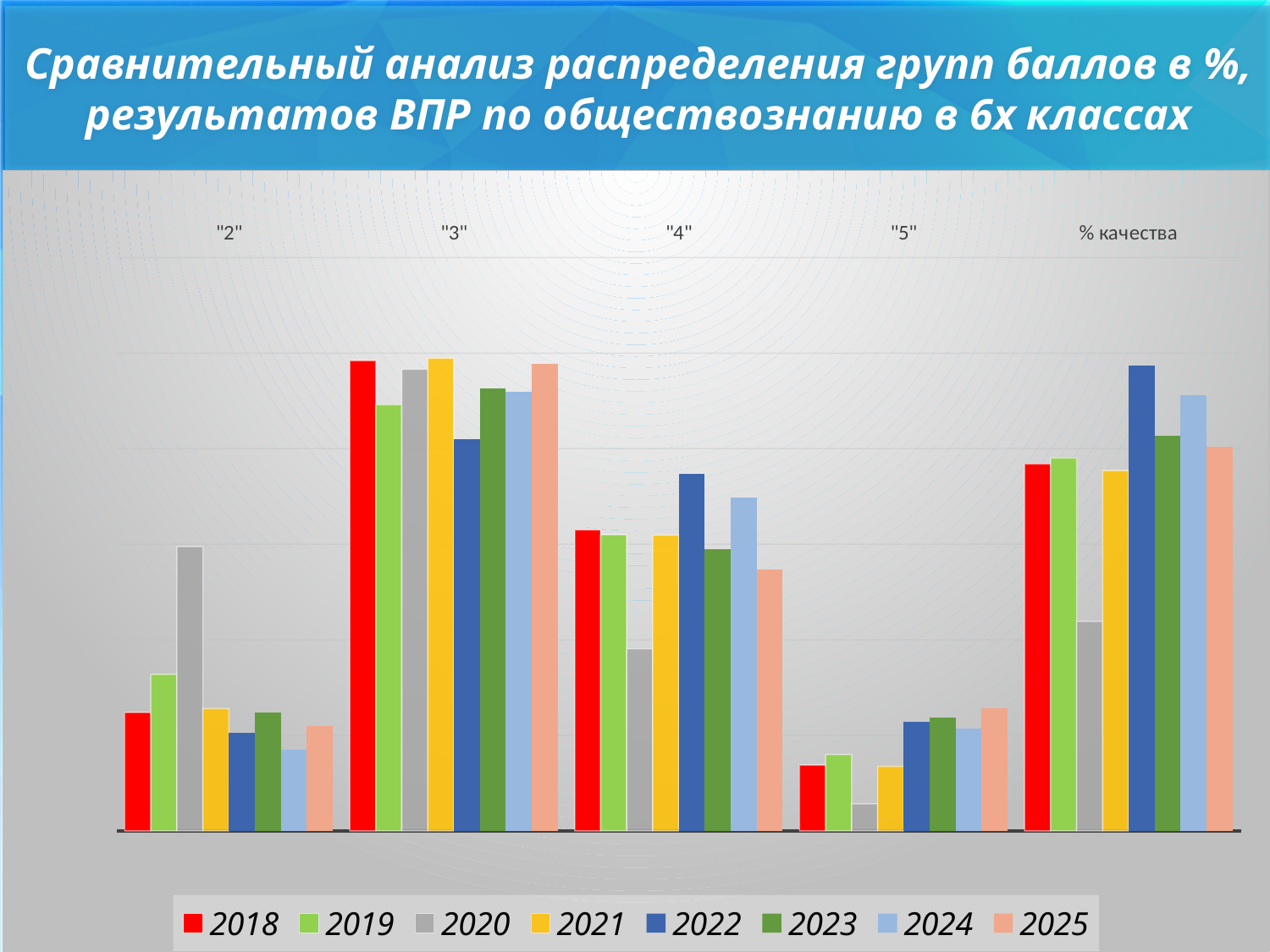
Which year has the lowest bar in the "2" category? 2024 Which year has the highest bar in the "4" category? 2022 In the "% качества" category, which is larger: the bar for 2021 or the bar for 2024? 2024 Which year has the highest bar in the "% качества" category? 2022 Which year has the lowest bar in the "3" category? 2022 Which colour represents the year 2018 in the legend? red How many categories are shown along the x axis of the chart? 5 Which year has the lowest bar in the "5" category? 2020 Which year has the highest bar in the "2" category? 2020 How many series does the legend list? 8 What kind of chart is shown on the slide? bar chart In the "2" category, which is larger: the bar for 2018 or the bar for 2019? 2019